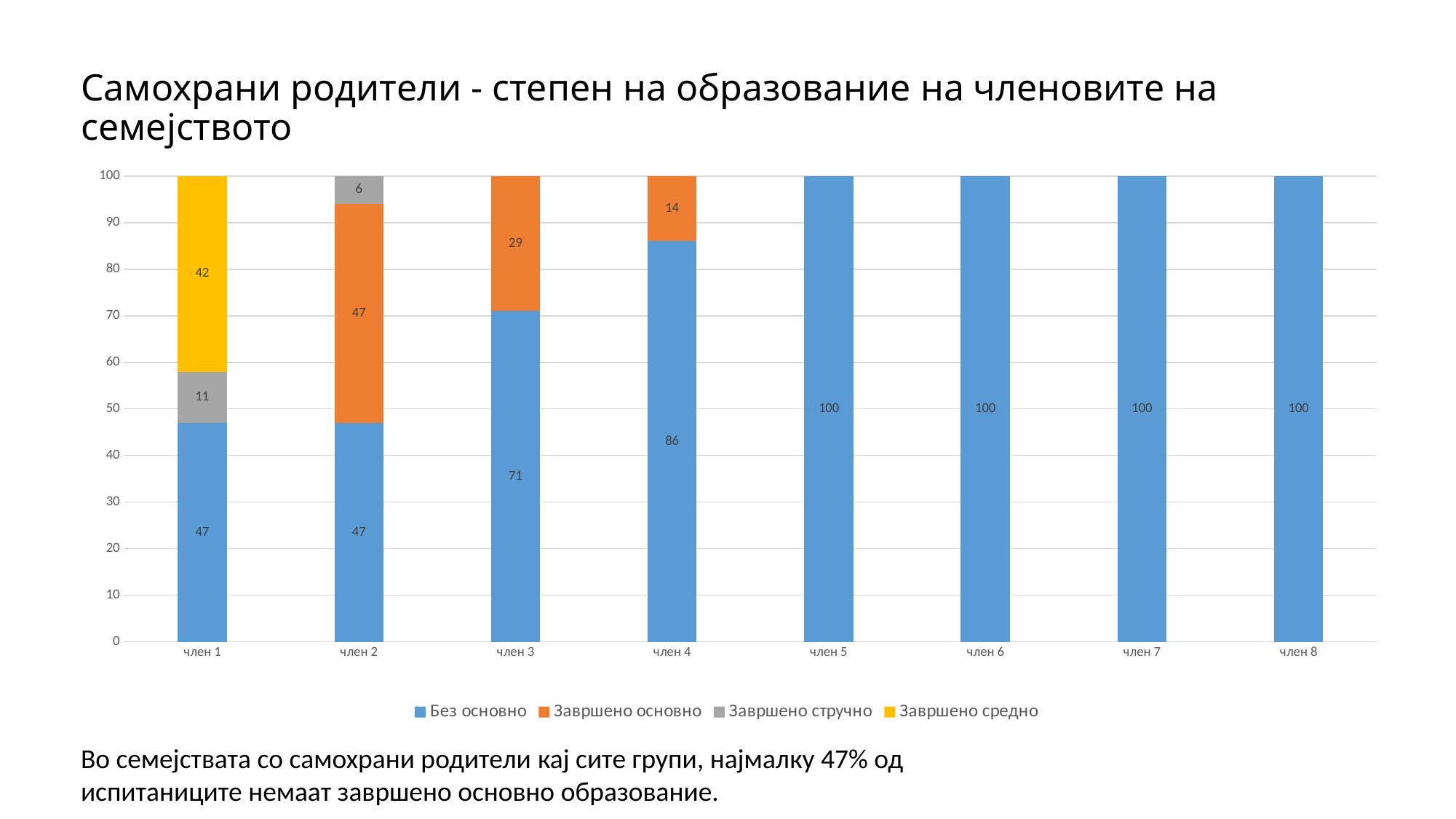
What is the value of "Завршено стручно" for член 2? 6 Which category has the lowest value for "Без основно"? член 1 and член 2 (47) Which is larger: the "Завршено основно" value for член 2 or for член 3? член 2 What is the difference between the "Без основно" values for член 4 and член 3? 15 How many categories are shown on the x axis? 8 What is the total of the stacked bar for член 1? 100 What kind of chart is shown on the slide? Stacked bar chart What is the value of "Без основно" for член 3? 71 What is the value of "Завршено средно" for член 1? 42 Which colour represents "Завршено средно" in the legend? Yellow What is the value of "Завршено основно" for член 4? 14 How many series does the legend list? 4